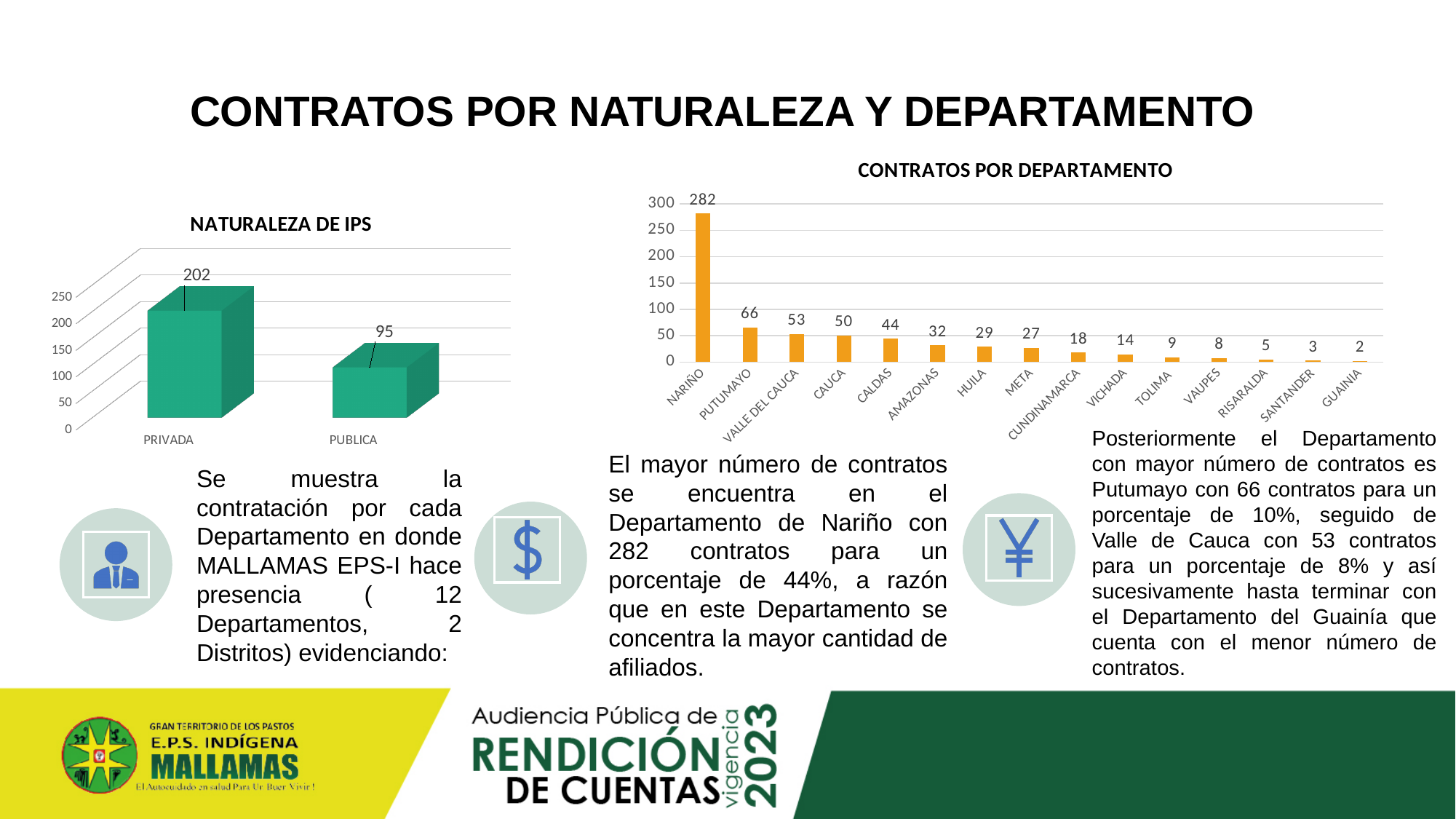
In the NATURALEZA DE IPS chart, what is the value for PRIVADA? 202 In the CONTRATOS POR DEPARTAMENTO chart, which is larger, CAUCA or CALDAS? CAUCA In the CONTRATOS POR DEPARTAMENTO chart, which department has the highest value? NARIÑO In the CONTRATOS POR DEPARTAMENTO chart, which department has the lowest value? GUAINIA In the CONTRATOS POR DEPARTAMENTO chart, what is the difference between NARIÑO and PUTUMAYO? 216 In the CONTRATOS POR DEPARTAMENTO chart, what is the value for CUNDINAMARCA? 18 In the CONTRATOS POR DEPARTAMENTO chart, what is the value for PUTUMAYO? 66 What type of chart is CONTRATOS POR DEPARTAMENTO? Bar chart In the NATURALEZA DE IPS chart, how many categories are shown? 2 In the NATURALEZA DE IPS chart, what is the value for PUBLICA? 95 In the CONTRATOS POR DEPARTAMENTO chart, how many departments are shown? 15 In the NATURALEZA DE IPS chart, what is the difference between PRIVADA and PUBLICA? 107